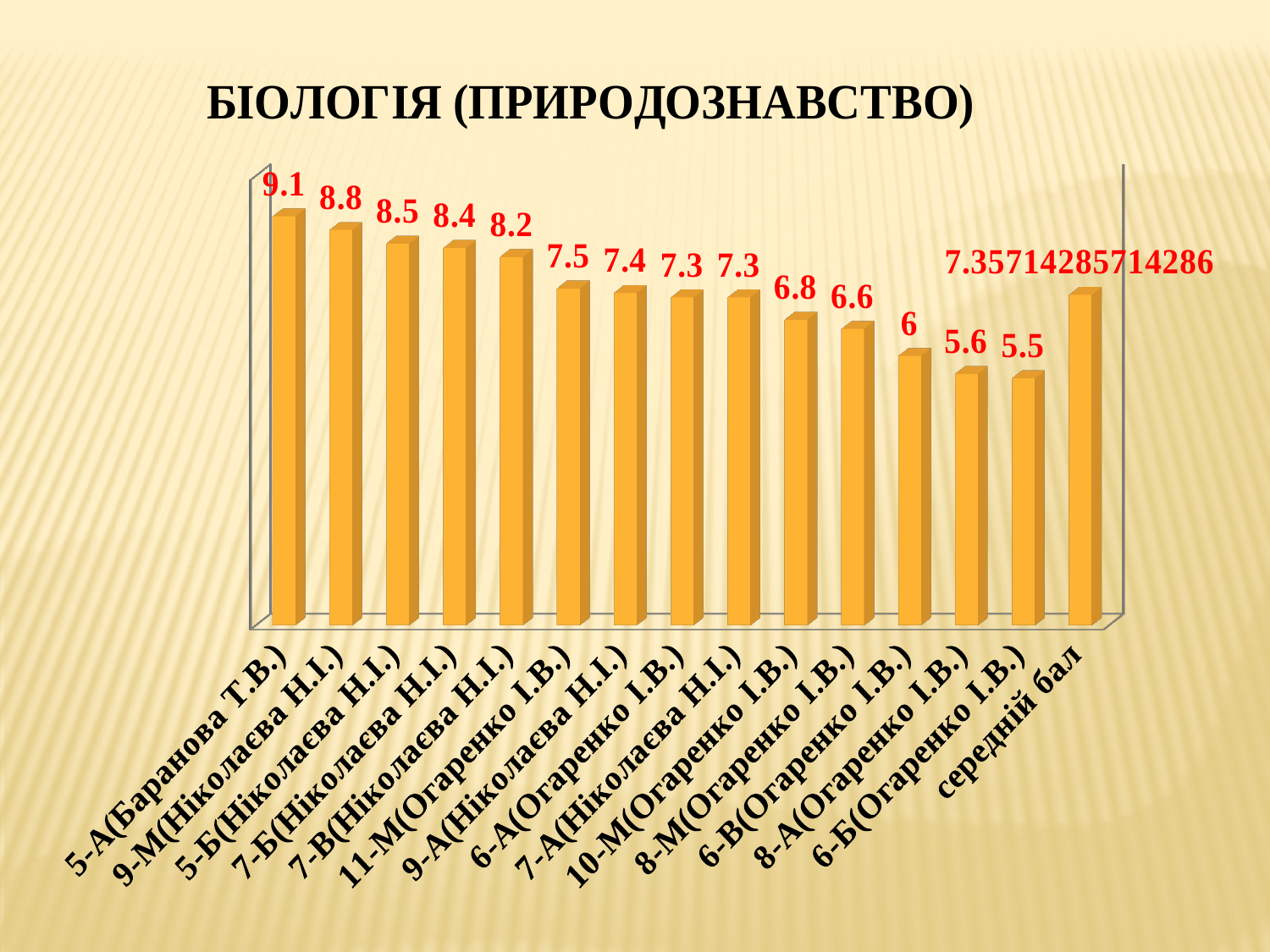
What is the value for 5-А(Баранова Т.В.)? 9.1 What kind of chart is shown on the slide? Bar chart How many bars are shown in the chart? 15 What is the difference between the values for 9-М(Ніколаєва Н.І.) and 5-Б(Ніколаєва Н.І.)? 0.3 What is the value shown for середній бал? 7.35714285714286 Which is larger, the value for 7-Б(Ніколаєва Н.І.) or the value for 7-В(Ніколаєва Н.І.)? 7-Б(Ніколаєва Н.І.) What is the difference between the values for 5-А(Баранова Т.В.) and 6-Б(Огаренко І.В.)? 3.6 What is the value for 6-В(Огаренко І.В.)? 6 Which category has the lowest value? 6-Б(Огаренко І.В.) What is the title of the chart? БІОЛОГІЯ (ПРИРОДОЗНАВСТВО) What is the value for 11-М(Огаренко І.В.)? 7.5 Which category has the highest value? 5-А(Баранова Т.В.)